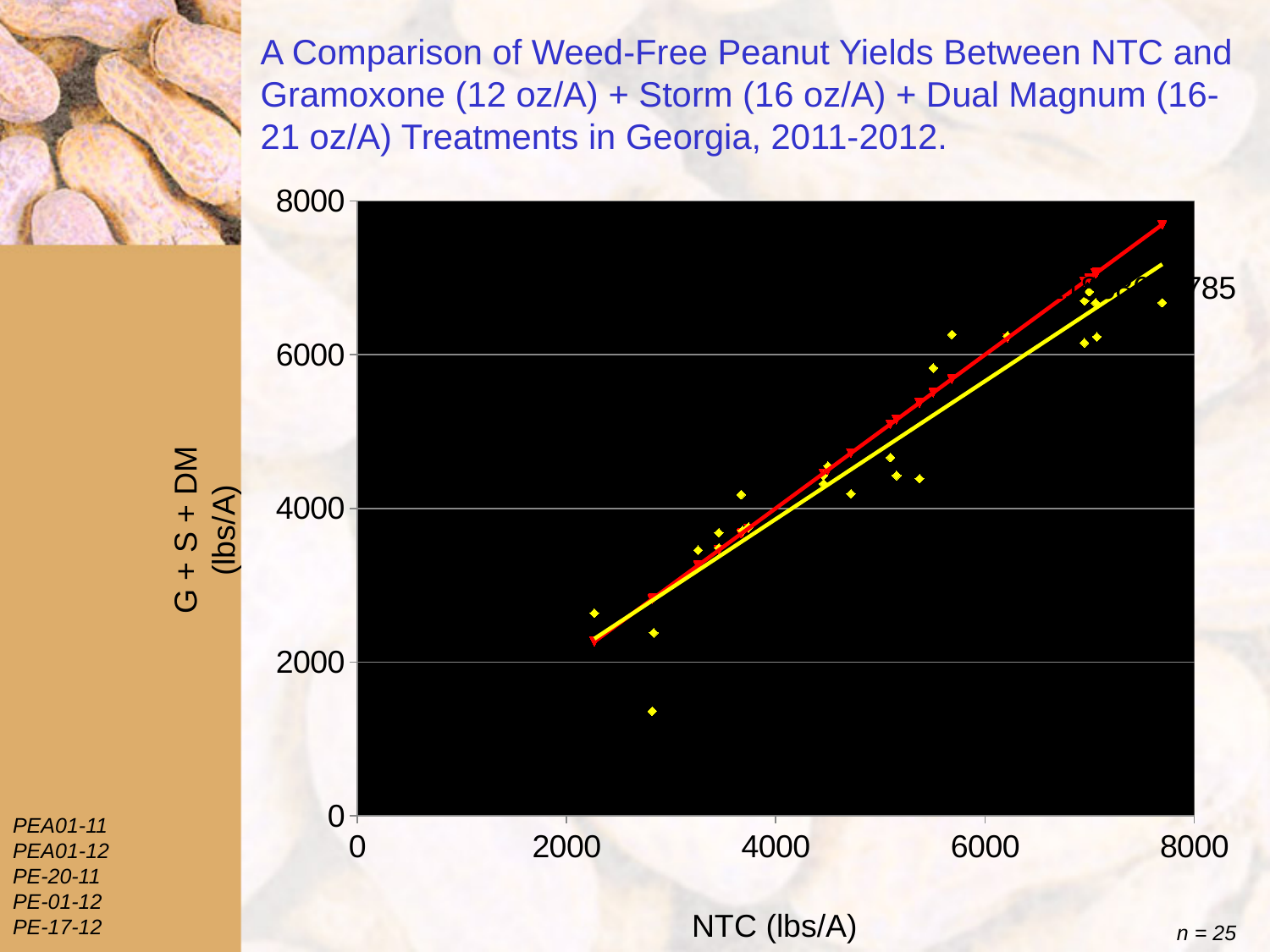
Is the G + S + DM value for the lowest plotted point greater or less than 4000? less Is the G + S + DM value for the lowest plotted point greater or less than 2000? less What kind of chart is shown on the slide? scatter chart Do the G + S + DM yields rise or fall as NTC yield increases along the x axis? rise Is the NTC value for the leftmost plotted point greater or less than 4000? less What is the label of the y axis? G + S + DM (lbs/A) How many data points does the chart contain, according to the n value printed on the slide? 25 What is the label of the x axis? NTC (lbs/A)